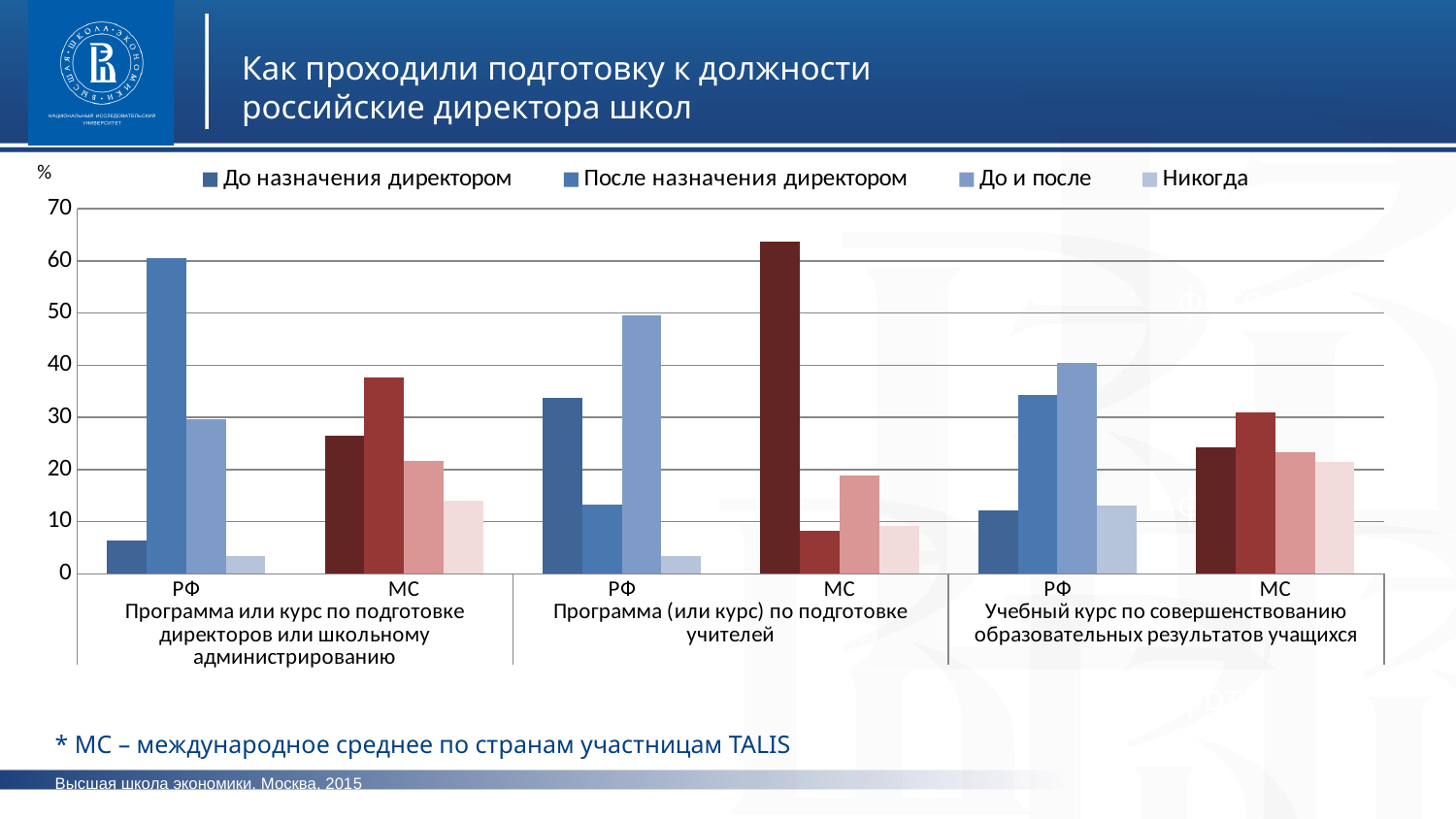
For РФ under 'Программа или курс по подготовке директоров или школьному администрированию', is the value for 'После назначения директором' greater or less than 50? greater For МС under 'Программа (или курс) по подготовке учителей', which series has the highest value? До назначения директором What are the four legend entries of the chart? До назначения директором, После назначения директором, До и после, Никогда For РФ under 'Учебный курс по совершенствованию образовательных результатов учащихся', which is larger: 'До и после' or 'До назначения директором'? До и после What kind of chart is shown on the slide? bar chart For РФ under 'Программа (или курс) по подготовке учителей', is the value for 'До и после' greater or less than 40? greater How many series does the legend list? 4 For РФ under 'Программа (или курс) по подготовке учителей', which series has the lowest value? Никогда For РФ under 'Программа или курс по подготовке директоров или школьному администрированию', is the value for 'Никогда' greater or less than 10? less For РФ under 'Программа или курс по подготовке директоров или школьному администрированию', which series has the highest value? После назначения директором How many training topics (category groups) are shown along the x axis? 3